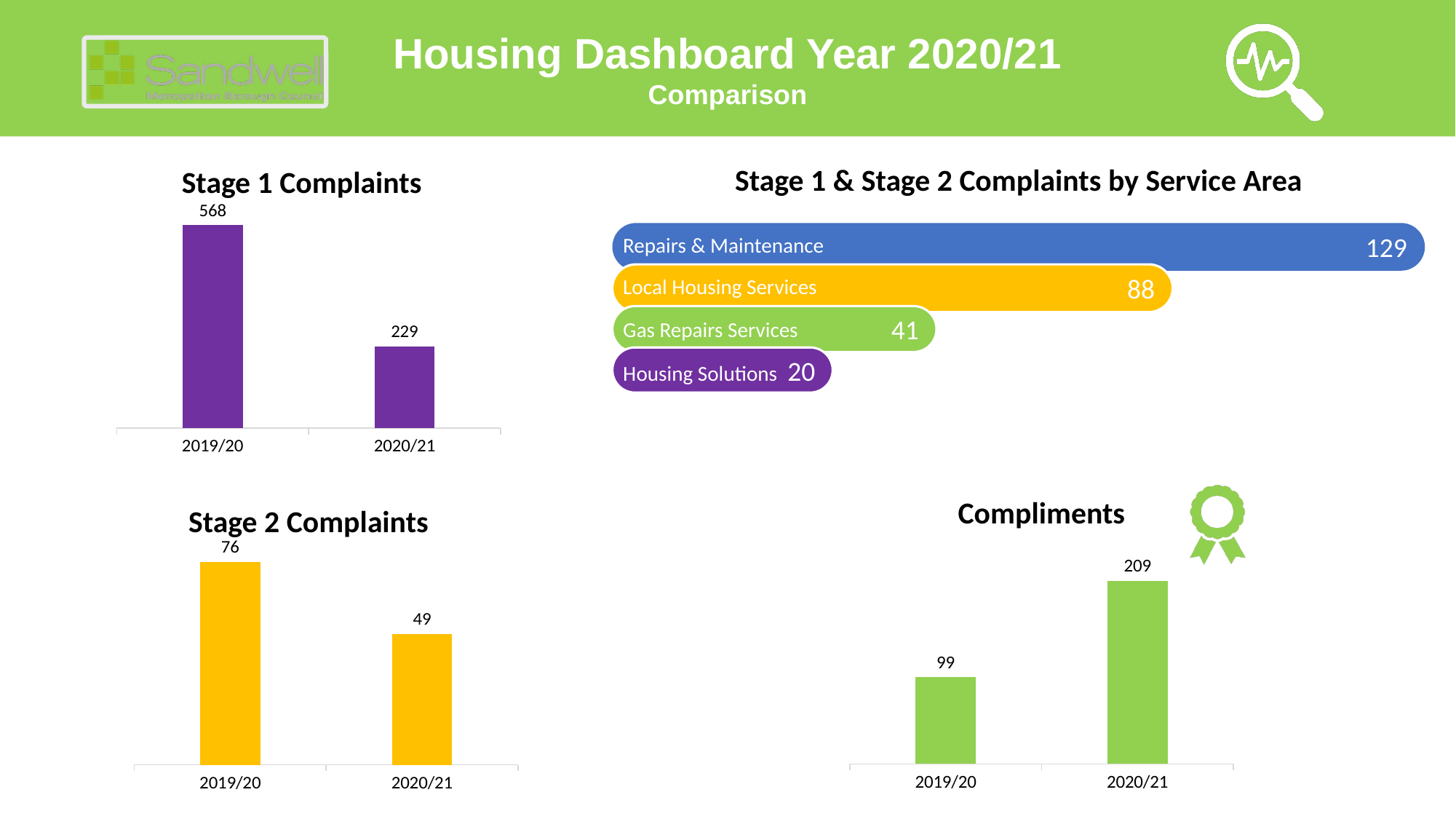
In the Stage 1 & Stage 2 Complaints by Service Area chart, what is the value for Gas Repairs Services? 41 What kind of chart is the Compliments chart? bar chart In the Compliments chart, what is the difference between the 2020/21 and 2019/20 values? 110 In the Stage 1 Complaints chart, what is the value for 2019/20? 568 In the Stage 2 Complaints chart, do the values rise or fall from 2019/20 to 2020/21? fall In the Stage 2 Complaints chart, which year has the higher value? 2019/20 In the Stage 1 Complaints chart, what is the value for 2020/21? 229 In the Stage 1 Complaints chart, what is the difference between the 2019/20 and 2020/21 values? 339 In the Compliments chart, what is the value for 2019/20? 99 How many service areas are shown in the Stage 1 & Stage 2 Complaints by Service Area chart? 4 In the Stage 2 Complaints chart, what is the value for 2020/21? 49 In the Stage 1 & Stage 2 Complaints by Service Area chart, which service area has the highest value? Repairs & Maintenance